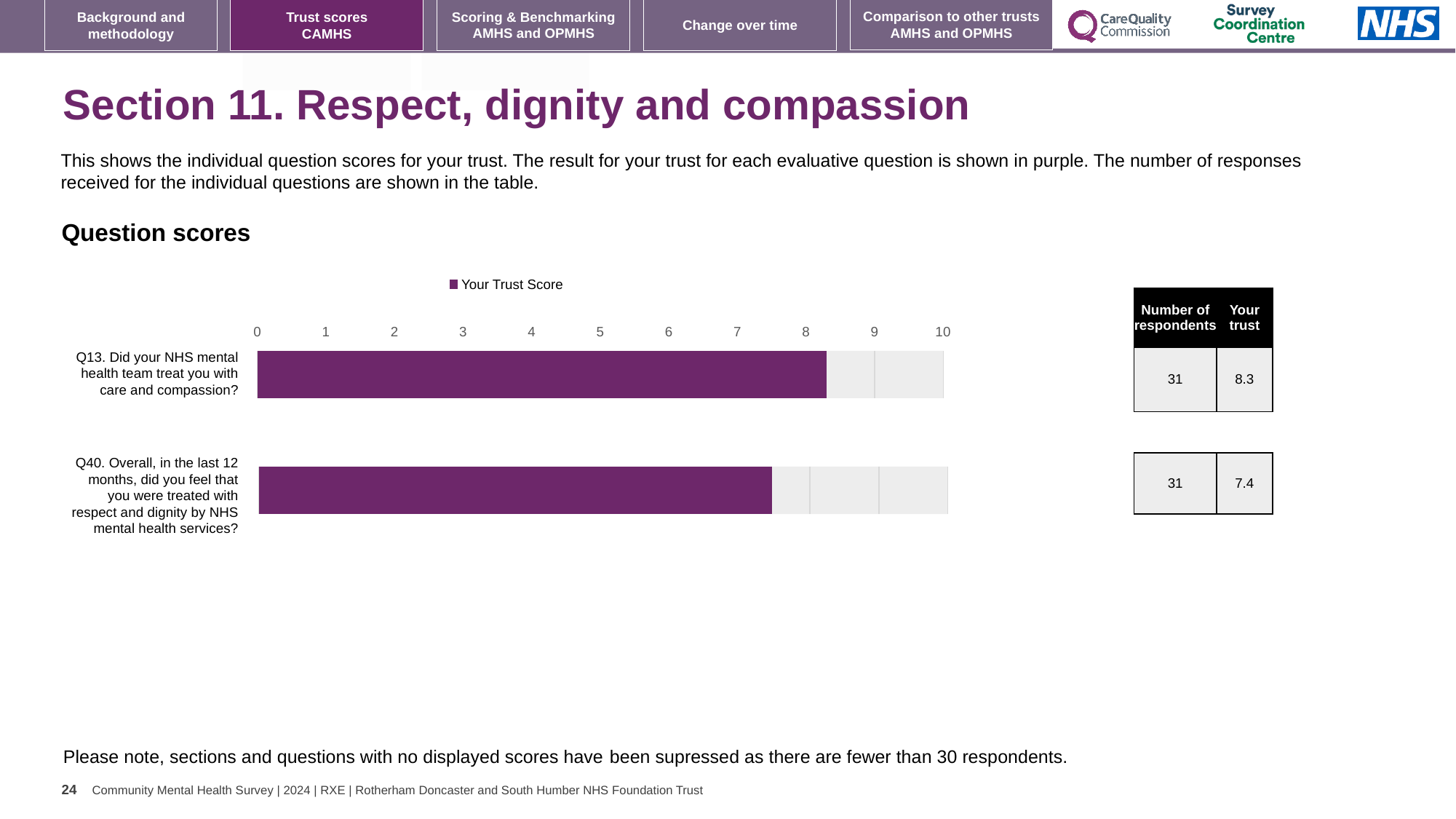
Is the trust score for Q40 greater or less than 8? less What is the difference between the trust scores for Q13 and Q40? 0.9 Which question has the higher trust score, Q13 or Q40? Q13 How many questions (bars) are plotted in the chart? 2 What type of chart is shown under "Question scores"? bar chart How many respondents answered Q13? 31 What is the name of the series shown in the chart legend? Your Trust Score Which question has the lowest trust score in the chart? Q40 What is the trust score for Q40 (Overall, in the last 12 months, did you feel that you were treated with respect and dignity by NHS mental health services?)? 7.4 What is the maximum value shown on the chart's horizontal axis? 10 How many series does the chart legend list? 1 What is the trust score for Q13 (Did your NHS mental health team treat you with care and compassion?)? 8.3